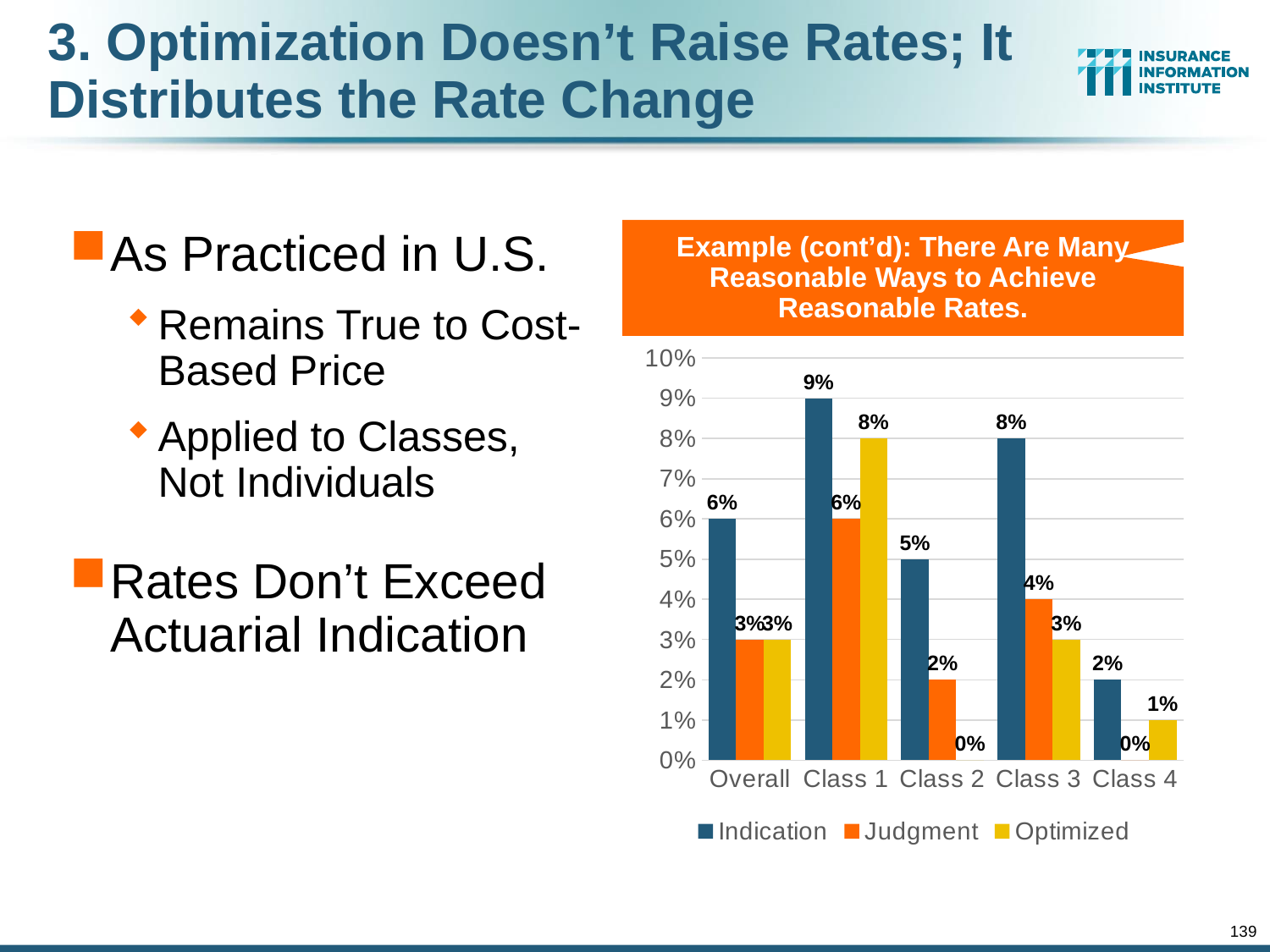
What is the Optimized value for Class 2? 0% How many series does the legend list? 3 Which is larger for Class 3, the Judgment value or the Optimized value? Judgment What kind of chart is shown on the slide? Bar chart What is the Optimized value for Class 4? 1% What is the Judgment value for Class 3? 4% How many categories are shown on the x axis? 5 Which category has the highest Indication value? Class 1 Which category has the lowest Indication value? Class 4 What is the Indication value for Class 1? 9% What is the title of the chart? Example (cont'd): There Are Many Reasonable Ways to Achieve Reasonable Rates. What is the difference between the Indication and Judgment values for Class 1? 3%